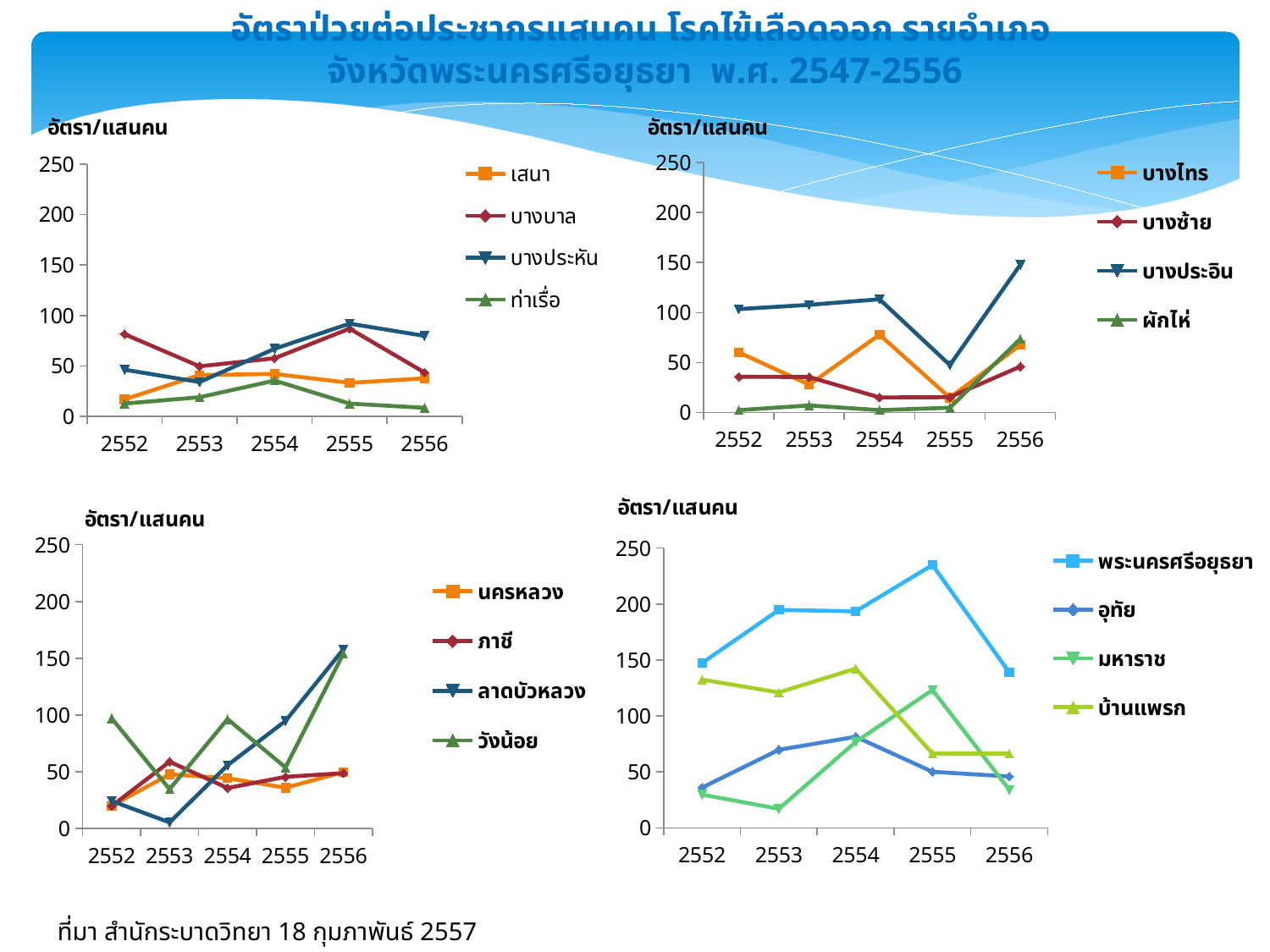
In the top-left chart, which series has the lowest value in 2556? ท่าเรื่อ How many series does the legend of the top-right chart list? 4 In the bottom-right chart, which series has the highest value in 2555? พระนครศรีอยุธยา In the bottom-right chart, does the value for พระนครศรีอยุธยา rise or fall from 2555 to 2556? fall What kind of chart is the top-left chart? line chart In the top-right chart, is the value for บางประอิน in 2556 greater or less than 100? greater In the bottom-right chart, is the value for พระนครศรีอยุธยา in 2555 greater or less than 200? greater In the top-right chart, which is larger in 2554, บางไทร or บางซ้าย? บางไทร In the bottom-left chart, is the value for ลาดบัวหลวง in 2553 greater or less than 50? less How many years are shown on the x axis of the bottom-left chart? 5 Which series are listed in the legend of the bottom-left chart? นครหลวง, ภาชี, ลาดบัวหลวง, วังน้อย In the top-right chart, which series has the highest value in 2554? บางประอิน